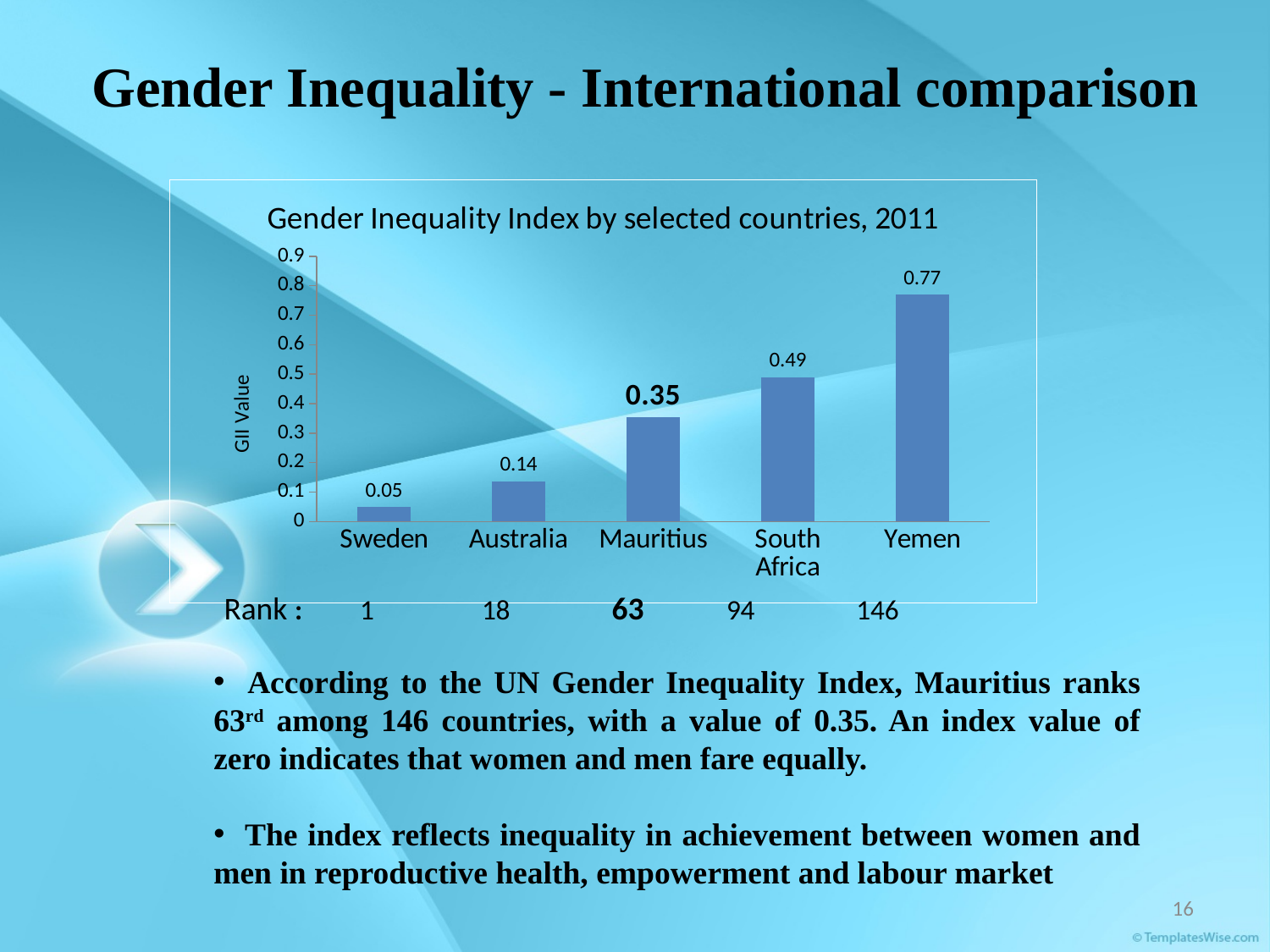
Is the GII value for South Africa greater or less than 0.4? greater What is the difference between the GII values of Yemen and South Africa? 0.28 What is the GII value for Sweden? 0.05 How many countries are shown in the chart? 5 What is the title of the chart? Gender Inequality Index by selected countries, 2011 What kind of chart is shown on the slide? Bar chart Which country has the lowest GII value? Sweden Which country has the highest GII value? Yemen Which has a higher GII value, South Africa or Australia? South Africa What is the GII value for Mauritius? 0.35 What is the GII value for Yemen? 0.77 What is the difference between the GII values of Mauritius and Australia? 0.21